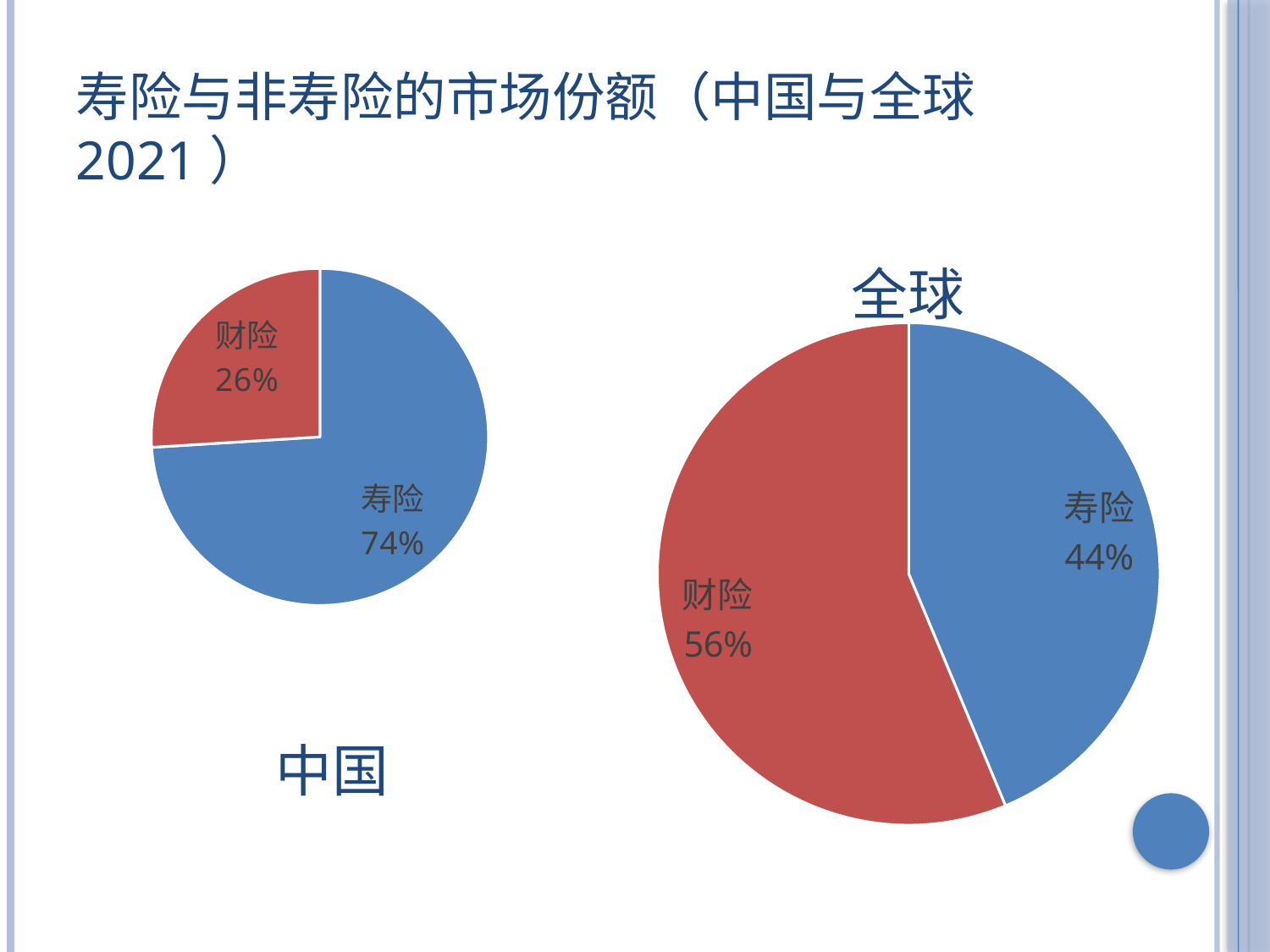
In the 全球 pie chart, what is the difference between the 财险 share and the 寿险 share? 12% In the 全球 pie chart, what is the share for 财险? 56% In the 全球 pie chart, what colour is the 财险 slice? red In the 中国 pie chart, which category has the largest share? 寿险 How many slices does the 全球 pie chart have? 2 In the 中国 pie chart, what is the difference between the 寿险 share and the 财险 share? 48% In the 中国 pie chart, what is the share for 寿险? 74% What type of chart is the 中国 chart? pie chart In the 全球 pie chart, what is the share for 寿险? 44% In the 全球 pie chart, which category has the smallest share? 寿险 In the 中国 pie chart, what is the share for 财险? 26% Which is larger: the 寿险 share in the 中国 chart or the 寿险 share in the 全球 chart? 中国